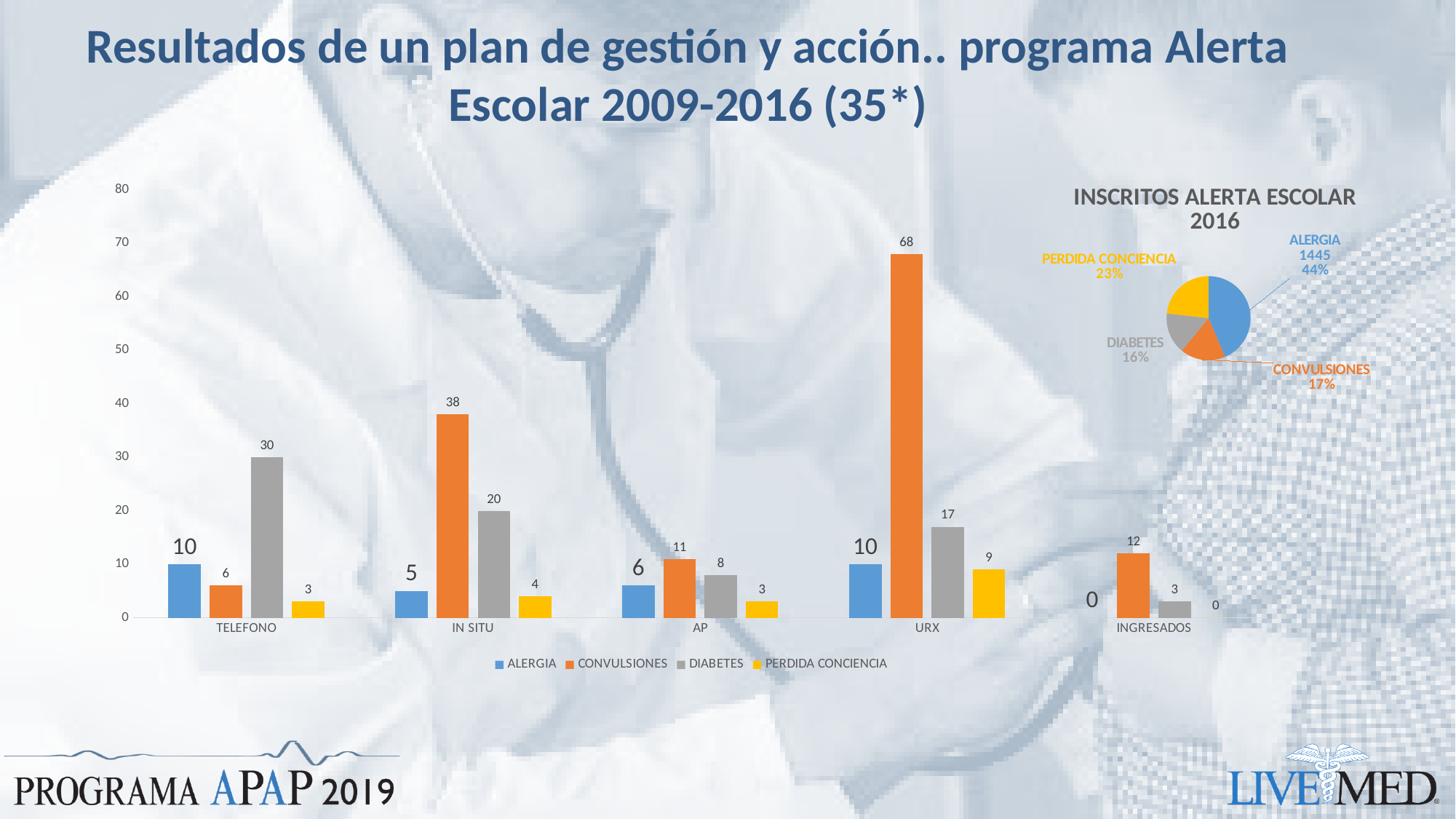
In the pie chart INSCRITOS ALERTA ESCOLAR 2016, what is the value shown for ALERGIA? 1445 In the bar chart on the left, what is the difference between the CONVULSIONES values for URX and IN SITU? 30 How many series does the legend of the bar chart on the left list? 4 What type of chart is the chart titled INSCRITOS ALERTA ESCOLAR 2016? pie chart In the bar chart on the left, which is larger in the AP category: CONVULSIONES or DIABETES? CONVULSIONES In the bar chart on the left, what is the value for ALERGIA in the IN SITU category? 5 In the bar chart on the left, what is the value for DIABETES in the TELEFONO category? 30 In the bar chart on the left, what is the value for CONVULSIONES in the URX category? 68 In the bar chart on the left, which category has the highest CONVULSIONES value? URX In the pie chart INSCRITOS ALERTA ESCOLAR 2016, what share does ALERGIA have? 44% How many categories are shown on the x axis of the bar chart on the left? 5 In the bar chart on the left, which category has the lowest DIABETES value? INGRESADOS